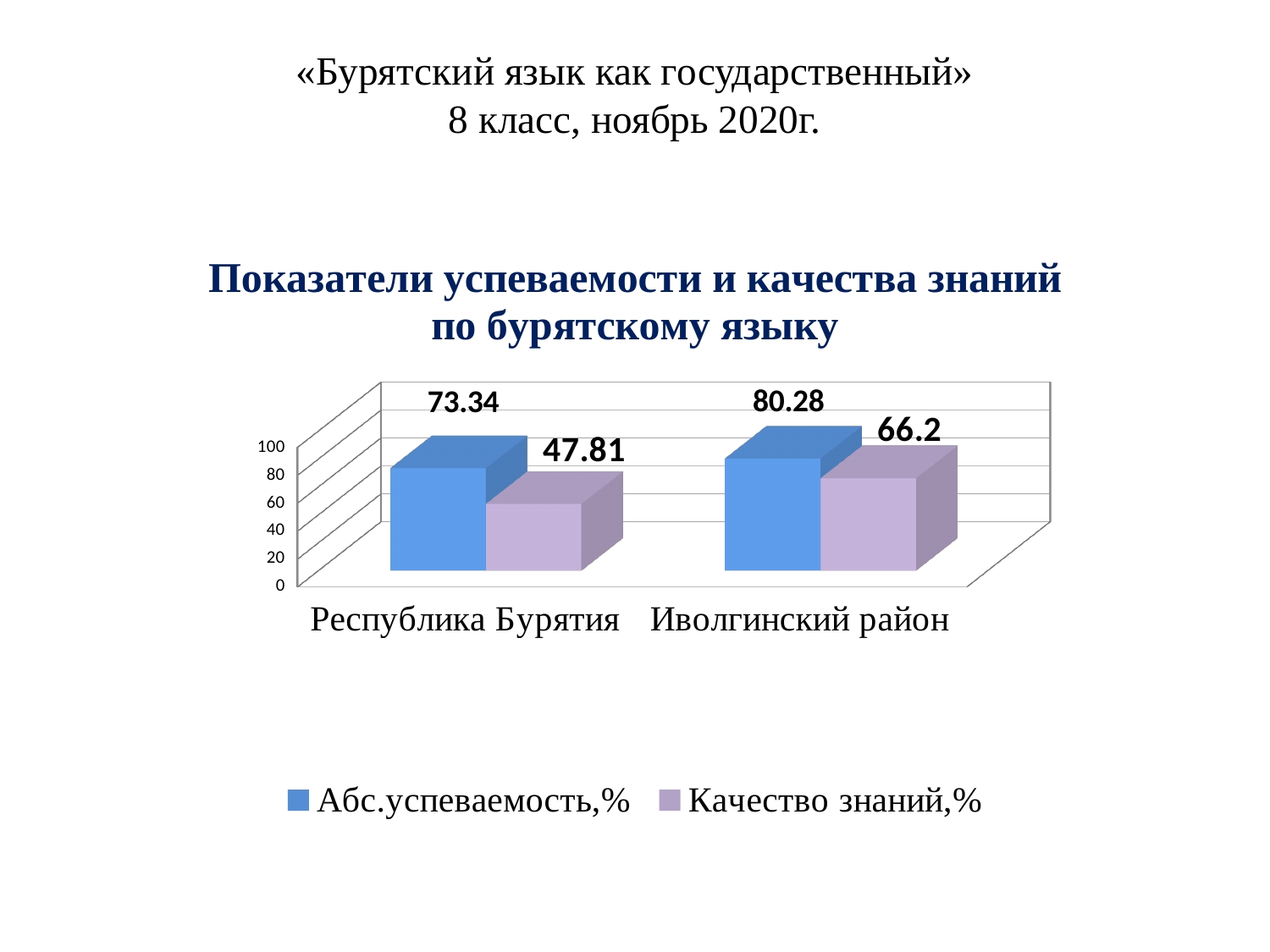
Which is larger: Качество знаний,% for Иволгинский район or for Республика Бурятия? Иволгинский район What is the value of Качество знаний,% for Республика Бурятия? 47.81 What is the value of Качество знаний,% for Иволгинский район? 66.2 What type of chart is shown on the slide? bar chart How many series does the chart legend list? 2 How many categories are shown on the x axis of the chart? 2 Which category has the highest value of Абс.успеваемость,%? Иволгинский район What is the difference between Абс.успеваемость,% for Иволгинский район and Республика Бурятия? 6.94 Is the value of Качество знаний,% for Республика Бурятия greater or less than 60? less What is the value of Абс.успеваемость,% for Иволгинский район? 80.28 Which category has the lowest value of Качество знаний,%? Республика Бурятия What is the value of Абс.успеваемость,% for Республика Бурятия? 73.34